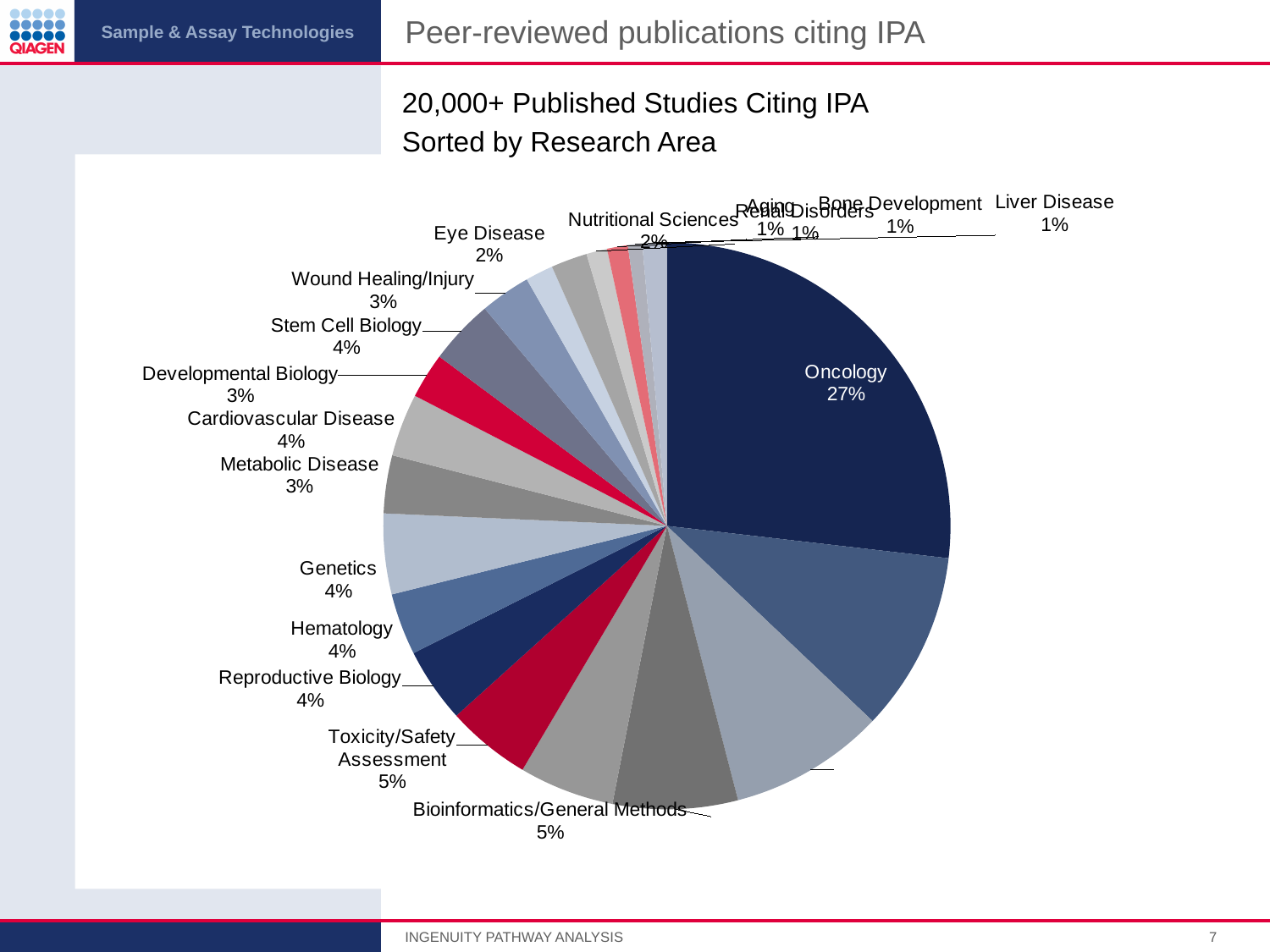
What percentage is shown for Bioinformatics/General Methods? 5% What percentage is shown for Toxicity/Safety Assessment? 5% What percentage is shown for Liver Disease? 1% What kind of chart is shown on the slide? pie chart What percentage is shown for Eye Disease? 2% What is the title of the chart? 20,000+ Published Studies Citing IPA Sorted by Research Area Which research area has the largest share of the pie? Oncology Which has a larger share, Toxicity/Safety Assessment or Wound Healing/Injury? Toxicity/Safety Assessment What percentage is shown for Stem Cell Biology? 4% What percentage of published studies citing IPA are in Oncology? 27% What is the difference in percentage points between Oncology and Bioinformatics/General Methods? 22% Which has a larger share, Hematology or Nutritional Sciences? Hematology